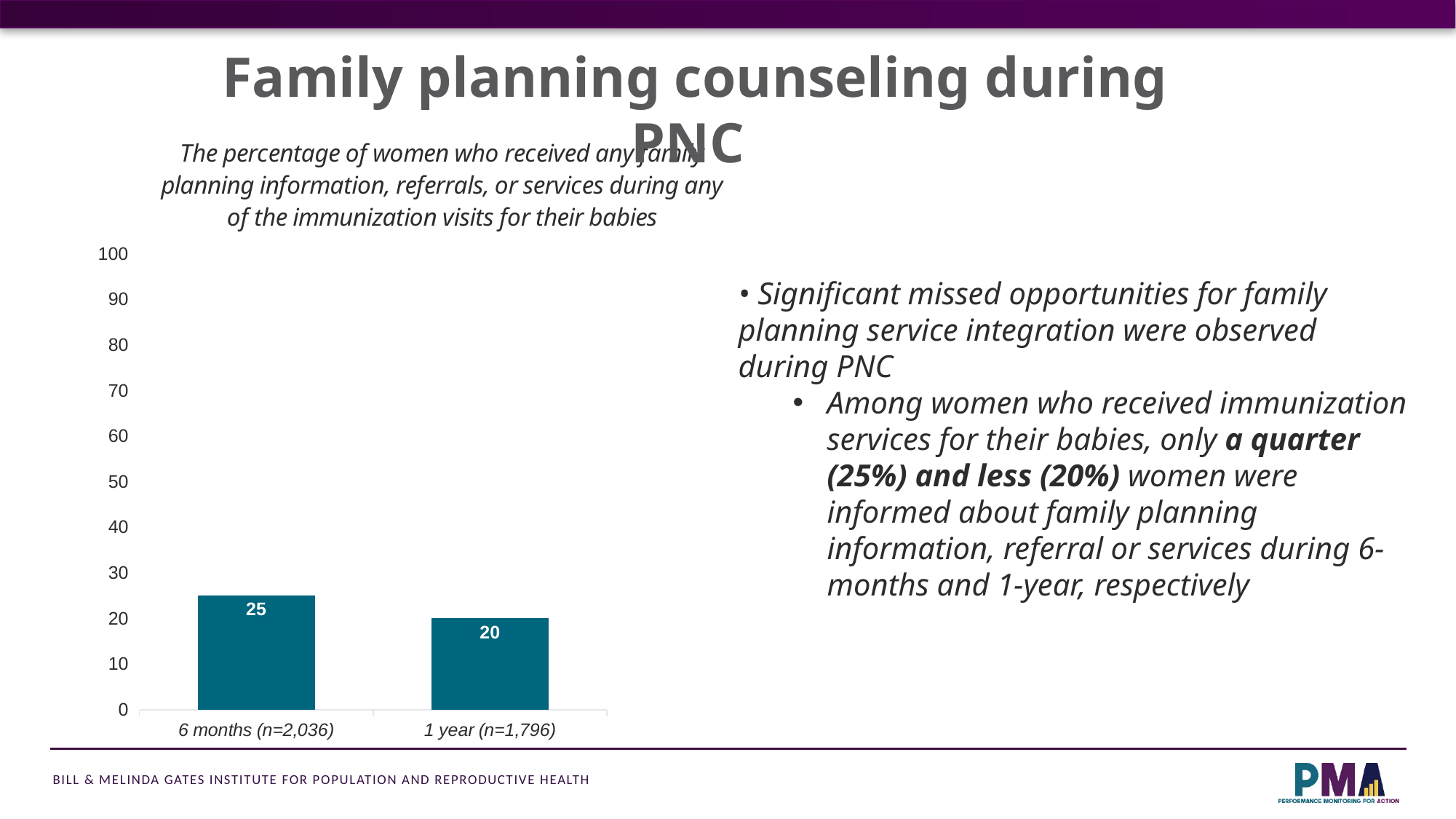
Which is larger, the value for 6 months (n=2,036) or the value for 1 year (n=1,796)? 6 months (n=2,036) What kind of chart is shown on the slide? bar chart How many categories are shown on the x axis? 2 Which category has the lowest value? 1 year (n=1,796) Which category has the highest value? 6 months (n=2,036) What is the value for 6 months (n=2,036)? 25 Do the values rise or fall from 6 months to 1 year? fall Is the value for 1 year (n=1,796) greater or less than 10? greater Is the value for 6 months (n=2,036) greater or less than 30? less What is the difference between the values for 6 months (n=2,036) and 1 year (n=1,796)? 5 What is the value for 1 year (n=1,796)? 20 What is the maximum value shown on the y axis? 100